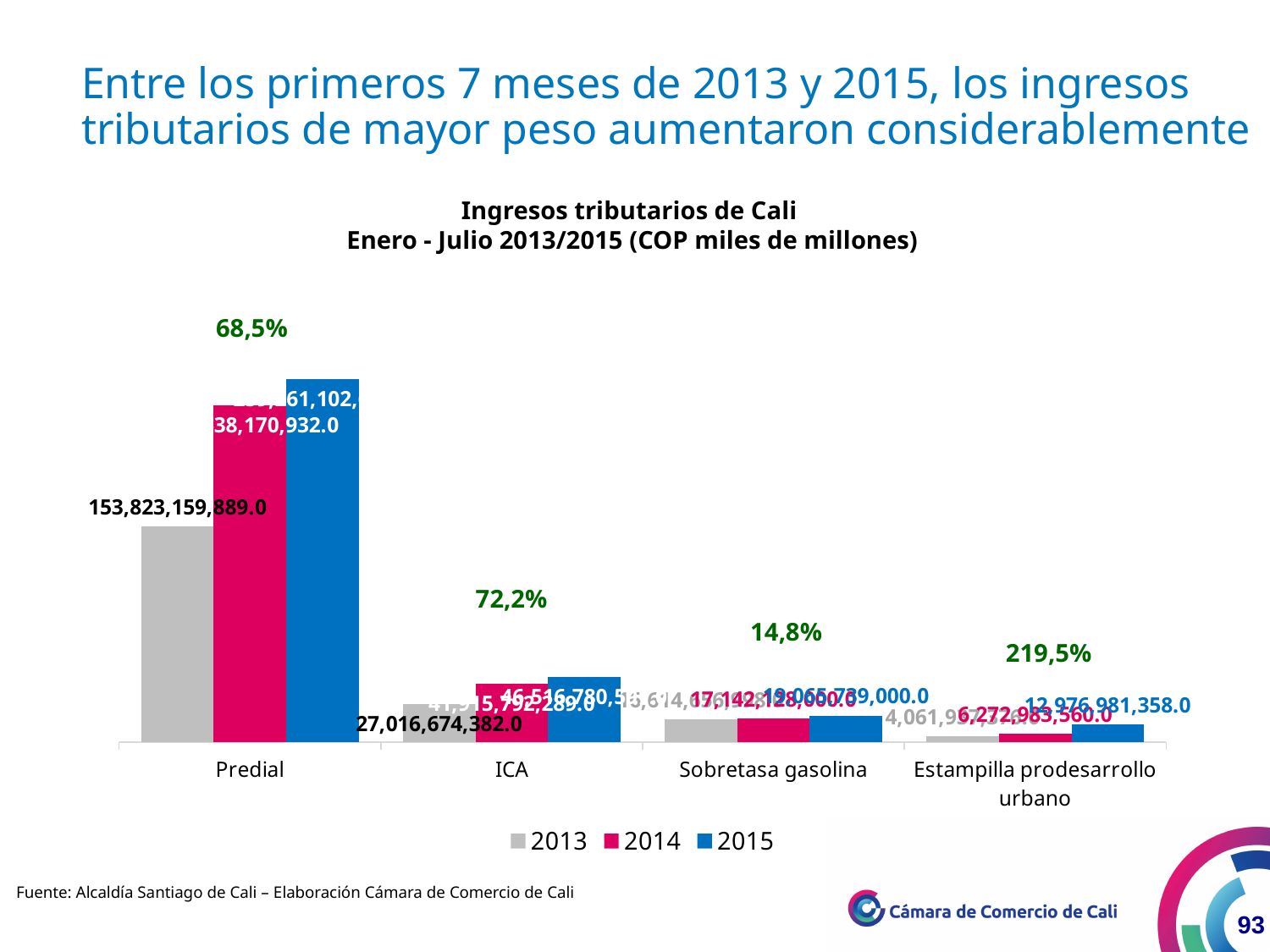
How many categories are shown on the x axis? 4 What percentage change is annotated above the Estampilla prodesarrollo urbano group? 219,5% What is the value for Predial in 2013? 153,823,159,889.0 What is the value for Estampilla prodesarrollo urbano in 2015? 12,976,981,358.0 How many series does the legend list? 3 Which category has the lowest values across all three years? Estampilla prodesarrollo urbano Which is larger: the 2013 value for Predial or the 2013 value for ICA? Predial Which category has the highest values across all three years? Predial What is the title of the chart? Ingresos tributarios de Cali Enero - Julio 2013/2015 (COP miles de millones) For Predial, which year has the tallest bar? 2015 What is the value for ICA in 2013? 27,016,674,382.0 What type of chart is shown on the slide? bar chart